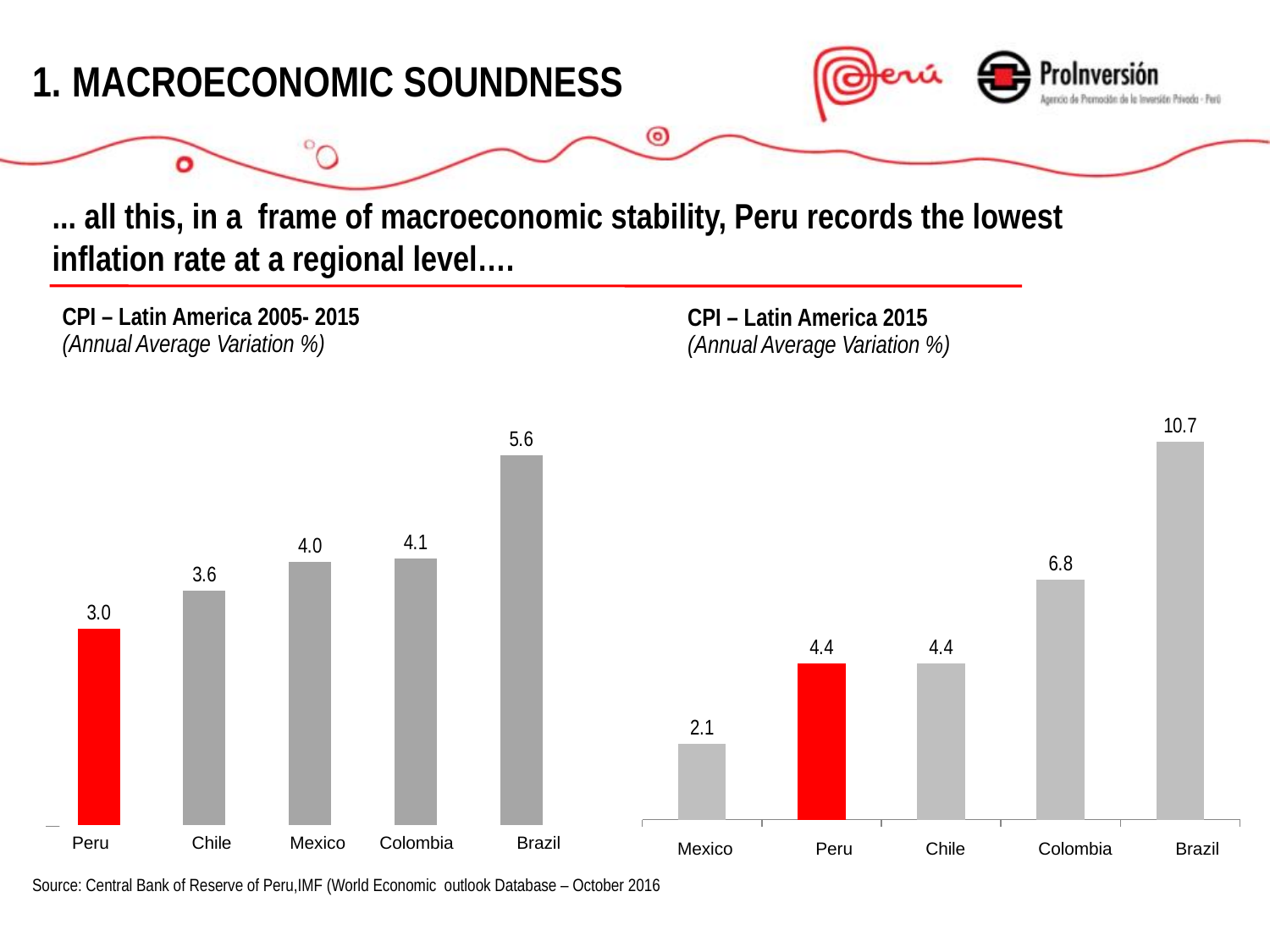
In the 'CPI – Latin America 2005-2015' chart, how many countries are shown? 5 In the 'CPI – Latin America 2005-2015' chart, which country has the lowest value? Peru In the 'CPI – Latin America 2005-2015' chart, what is the value for Peru? 3.0 In the 'CPI – Latin America 2015' chart, what is the value for Colombia? 6.8 In the 'CPI – Latin America 2015' chart, which is larger, the value for Colombia or the value for Chile? Colombia In the 'CPI – Latin America 2005-2015' chart, what is the difference between Brazil and Peru? 2.6 In the 'CPI – Latin America 2005-2015' chart, which country has the highest value? Brazil In the 'CPI – Latin America 2015' chart, which country has the highest value? Brazil In the 'CPI – Latin America 2015' chart, what is the value for Mexico? 2.1 In the 'CPI – Latin America 2015' chart, what is the difference between Brazil and Colombia? 3.9 What type of chart is the 'CPI – Latin America 2015' chart? Bar chart In the 'CPI – Latin America 2015' chart, which country has the lowest value? Mexico